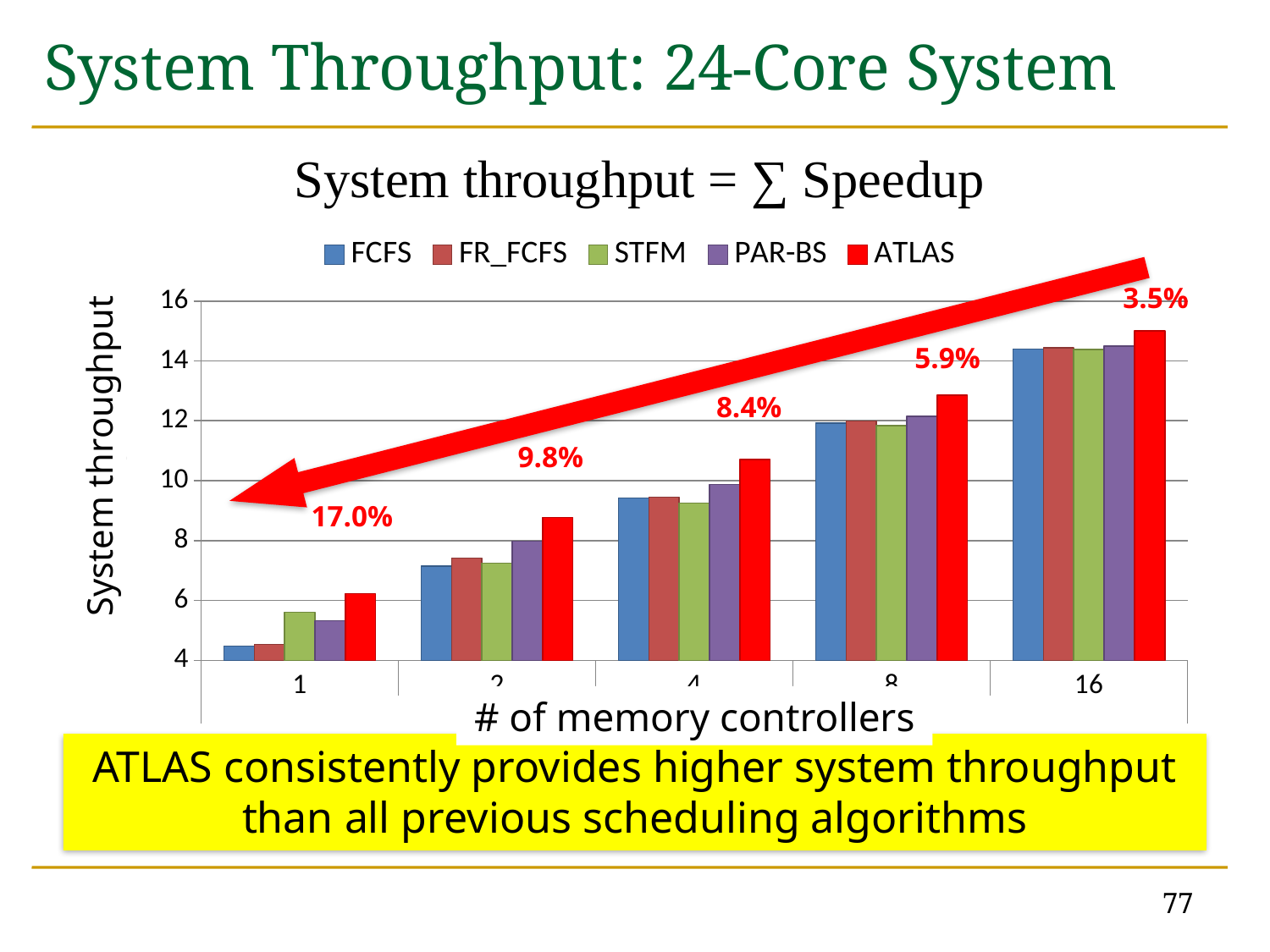
Which series has the highest system throughput at 16 memory controllers? ATLAS Is the system throughput for STFM at 4 memory controllers greater or less than 10? less Is the system throughput for ATLAS at 1 memory controller greater or less than 6? greater Is the system throughput for FCFS at 1 memory controller greater or less than 6? less How many memory-controller configurations (categories) are plotted along the x axis? 5 At 1 memory controller, which has higher system throughput: ATLAS or FCFS? ATLAS How many series does the chart legend list? 5 Does system throughput rise or fall as the number of memory controllers increases? rises What percentage improvement is annotated above the bars for 1 memory controller? 17.0% Which series has the highest system throughput at 1 memory controller? ATLAS What kind of chart is shown on the slide? bar chart